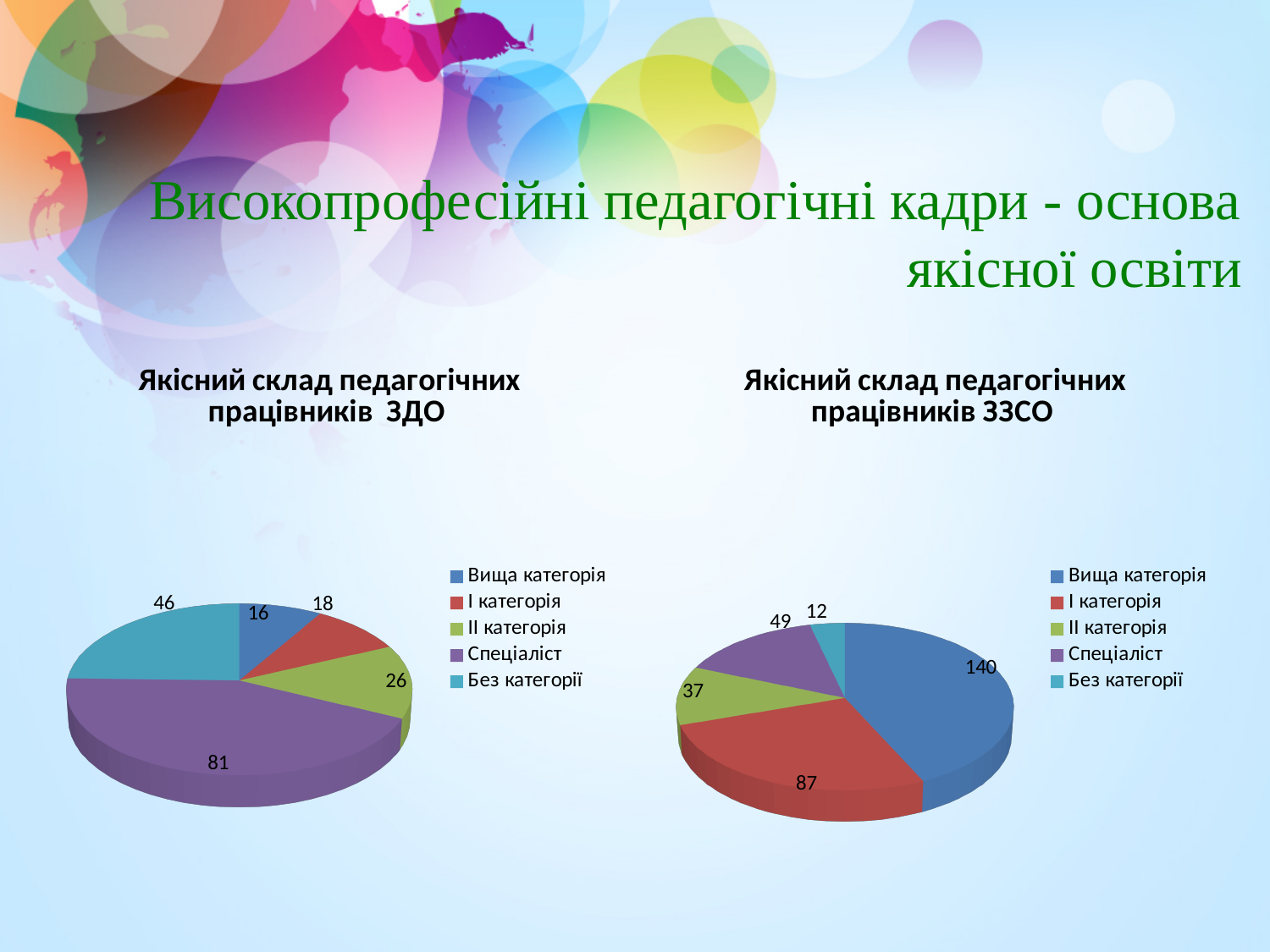
In the chart titled 'Якісний склад педагогічних працівників ЗДО', which category has the largest value? Спеціаліст In the chart titled 'Якісний склад педагогічних працівників ЗДО', what is the value for Спеціаліст? 81 What kind of chart is the chart titled 'Якісний склад педагогічних працівників ЗДО'? Pie chart In the chart titled 'Якісний склад педагогічних працівників ЗДО', which is larger: ІІ категорія or І категорія? ІІ категорія How many categories does the chart titled 'Якісний склад педагогічних працівників ЗЗСО' show? 5 In the chart titled 'Якісний склад педагогічних працівників ЗЗСО', which category has the smallest value? Без категорії In the chart titled 'Якісний склад педагогічних працівників ЗДО', which category has the smallest value? Вища категорія In the chart titled 'Якісний склад педагогічних працівників ЗЗСО', what is the total of all categories? 325 In the chart titled 'Якісний склад педагогічних працівників ЗЗСО', what is the value for Вища категорія? 140 In the chart titled 'Якісний склад педагогічних працівників ЗДО', what is the value for Без категорії? 46 In the chart titled 'Якісний склад педагогічних працівників ЗЗСО', what is the difference between Вища категорія and І категорія? 53 In the chart titled 'Якісний склад педагогічних працівників ЗЗСО', what is the value for ІІ категорія? 37